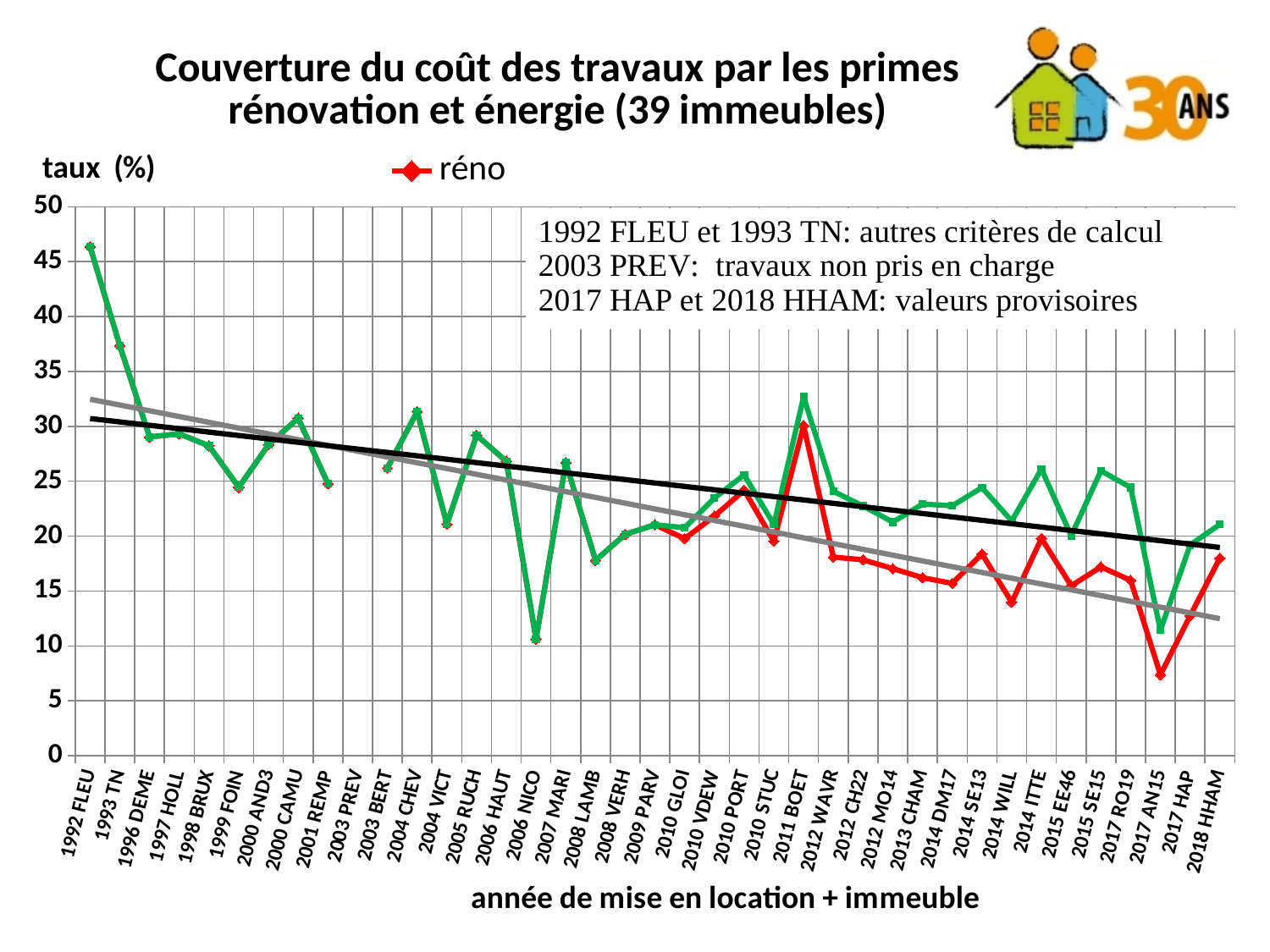
Is the réno value for 2017 AN15 greater or less than 10? less Is the réno value for 2011 BOET greater or less than 25? greater How many buildings (categories) are plotted along the x axis? 39 Which has the larger réno value, 1992 FLEU or 1993 TN? 1992 FLEU Is the réno value for 1992 FLEU greater or less than 40? greater How many series does the legend list? 1 Which building has the highest réno value? 1992 FLEU Do the réno values generally rise or fall from left to right along the x axis? fall What is the title of the x axis? année de mise en location + immeuble Which building has the lowest réno value? 2017 AN15 What kind of chart is shown on the slide? line chart